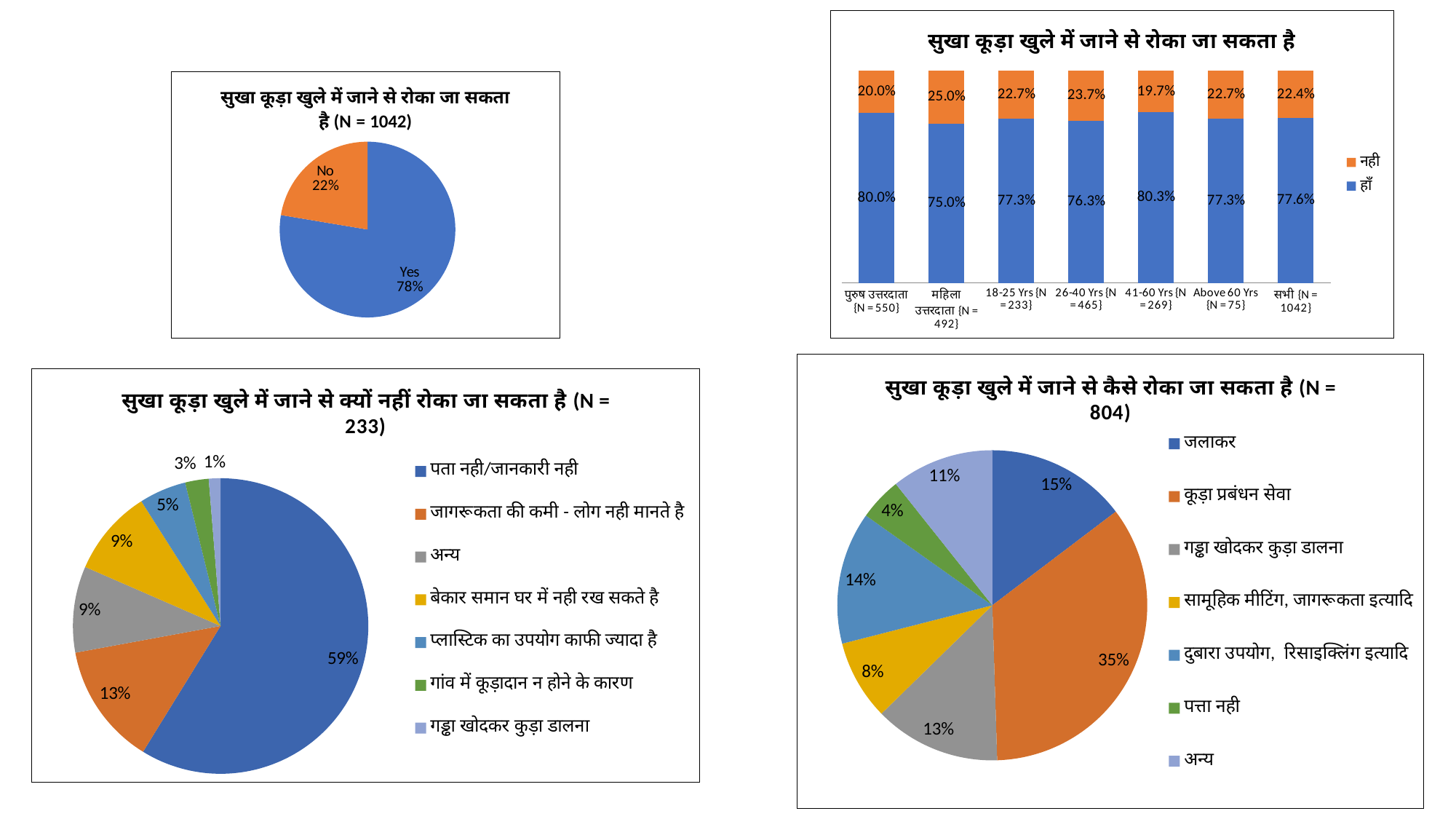
In the bottom-left pie chart (N = 233), how many categories does the legend list? 7 In the top-right stacked bar chart, what is the नही value for महिला उत्तरदाता {N = 492}? 25.0% In the top-right stacked bar chart, how many categories are shown on the x axis? 7 In the top-right stacked bar chart, what is the हाँ value for 41-60 Yrs {N = 269}? 80.3% What kind of chart is the top-right chart? Stacked bar chart In the top-left pie chart (N = 1042), what share of respondents answered No? 22% In the bottom-right pie chart (N = 804), what share is दुबारा उपयोग, रिसाइक्लिंग इत्यादि? 14% In the top-right stacked bar chart, what is the difference between the हाँ values for पुरुष उत्तरदाता {N = 550} and महिला उत्तरदाता {N = 492}? 5.0% In the top-left pie chart (N = 1042), what share of respondents answered Yes? 78% In the top-right stacked bar chart, which category has the highest नही value? महिला उत्तरदाता {N = 492} In the bottom-left pie chart (N = 233), what share is पता नही/जानकारी नही? 59% In the bottom-right pie chart (N = 804), which category has the largest share? कूड़ा प्रबंधन सेवा